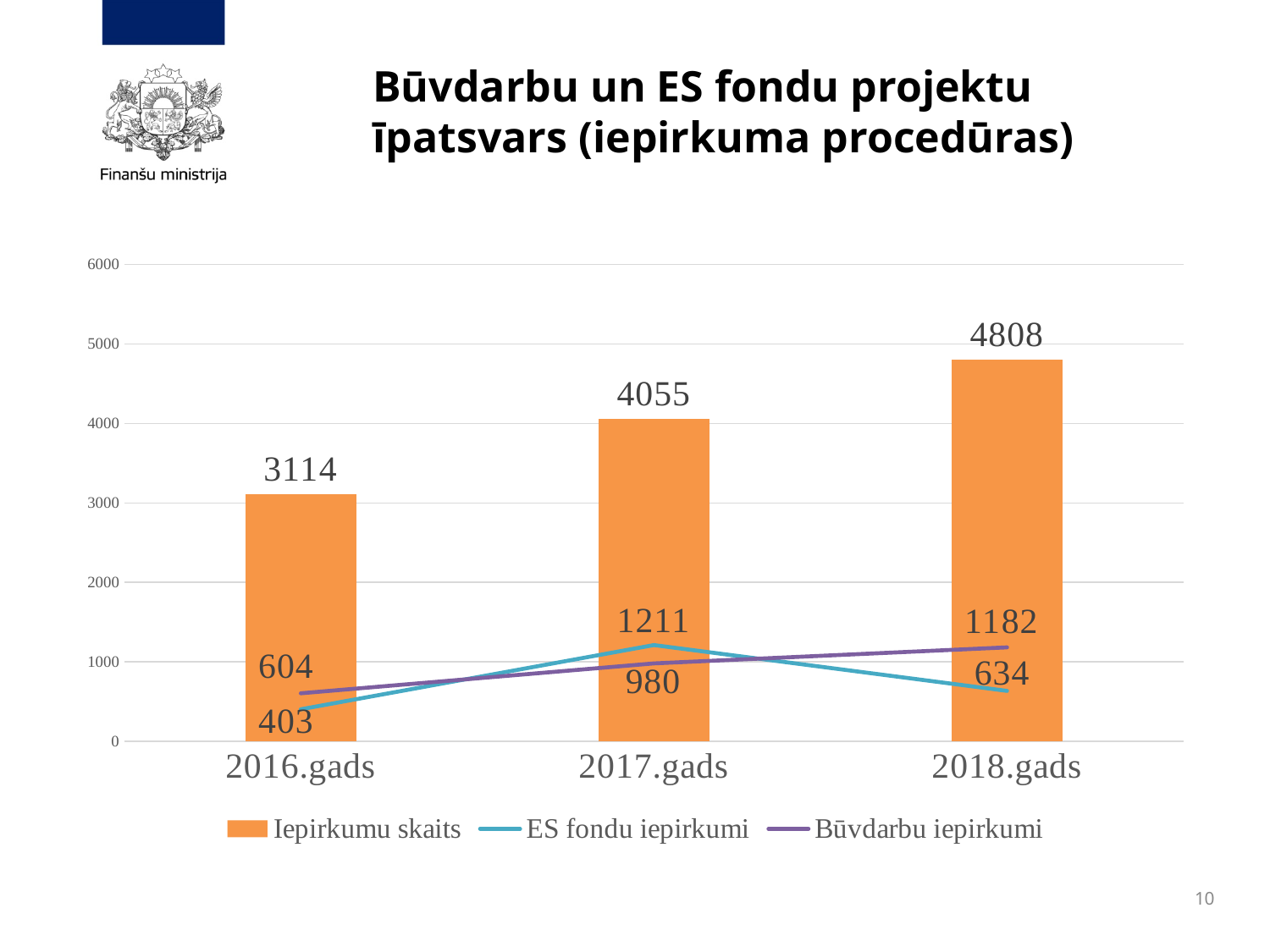
What is the difference in Iepirkumu skaits between 2018.gads and 2017.gads? 753 How many years are shown on the x axis? 3 In 2018.gads, which is larger: ES fondu iepirkumi or Būvdarbu iepirkumi? Būvdarbu iepirkumi What is the value of ES fondu iepirkumi for 2017.gads? 1211 How many series does the legend list? 3 Does Iepirkumu skaits rise or fall from 2016.gads to 2018.gads? rise Which year has the lowest Būvdarbu iepirkumi? 2016.gads Which series is shown as orange bars? Iepirkumu skaits What is the value of Būvdarbu iepirkumi for 2018.gads? 1182 What is the value of Iepirkumu skaits for 2017.gads? 4055 Which year has the highest Iepirkumu skaits? 2018.gads What is the value of ES fondu iepirkumi for 2016.gads? 403